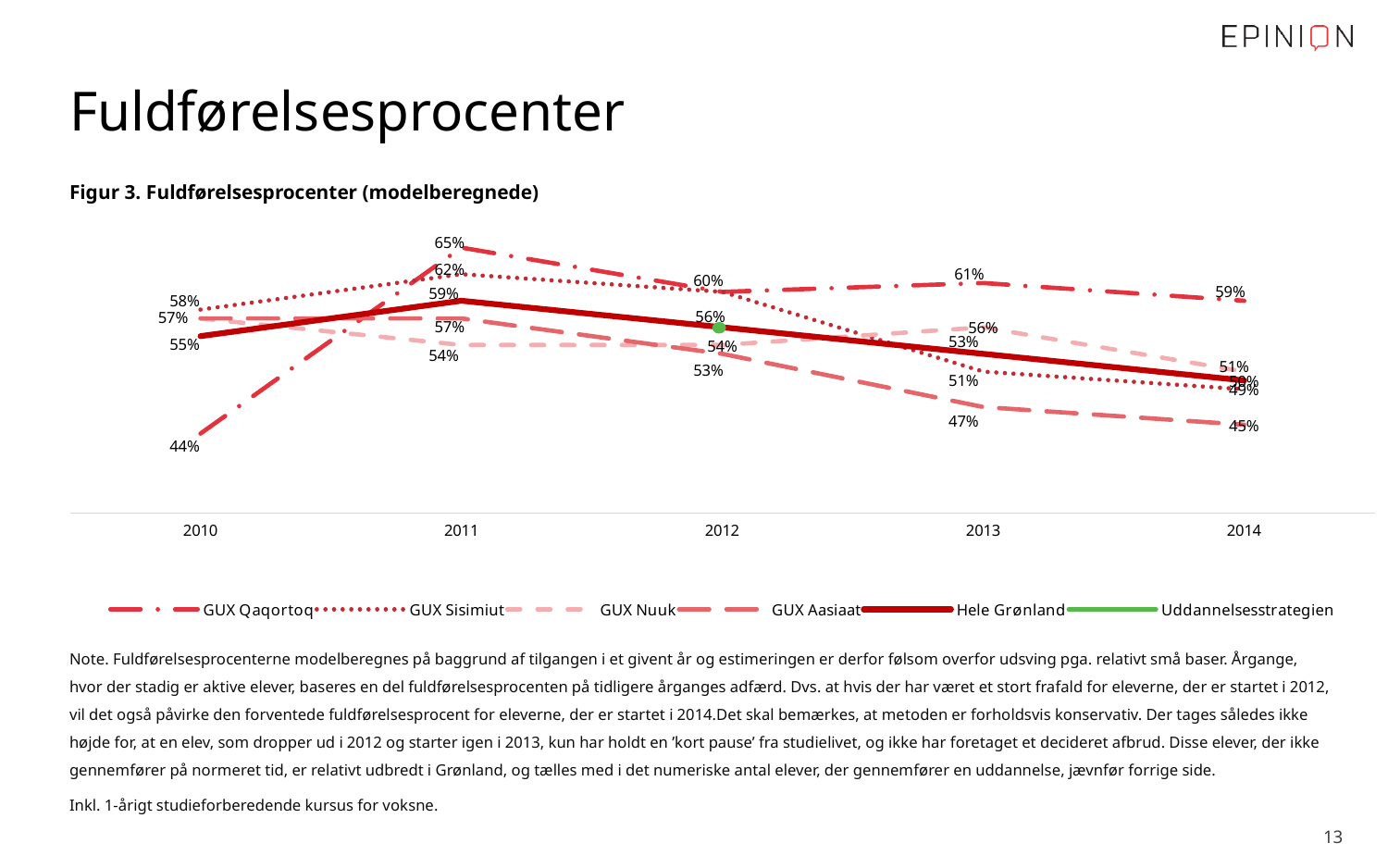
Which is larger in 2013: GUX Qaqortoq or GUX Aasiaat? GUX Qaqortoq How many years are shown on the x axis of the chart? 5 What is the value for Hele Grønland in 2011? 59% Does the value for GUX Aasiaat rise or fall from 2011 to 2014? fall How many series does the legend of the chart list? 6 What is the value for GUX Aasiaat in 2014? 45% What type of chart is shown in Figur 3? line chart Which series has the highest value in 2011? GUX Qaqortoq Which series has the lowest value in 2010? GUX Qaqortoq What is the value for GUX Qaqortoq in 2011? 65% By how many percentage points did GUX Qaqortoq rise from 2010 to 2011? 21 percentage points What is the value for GUX Qaqortoq in 2010? 44%